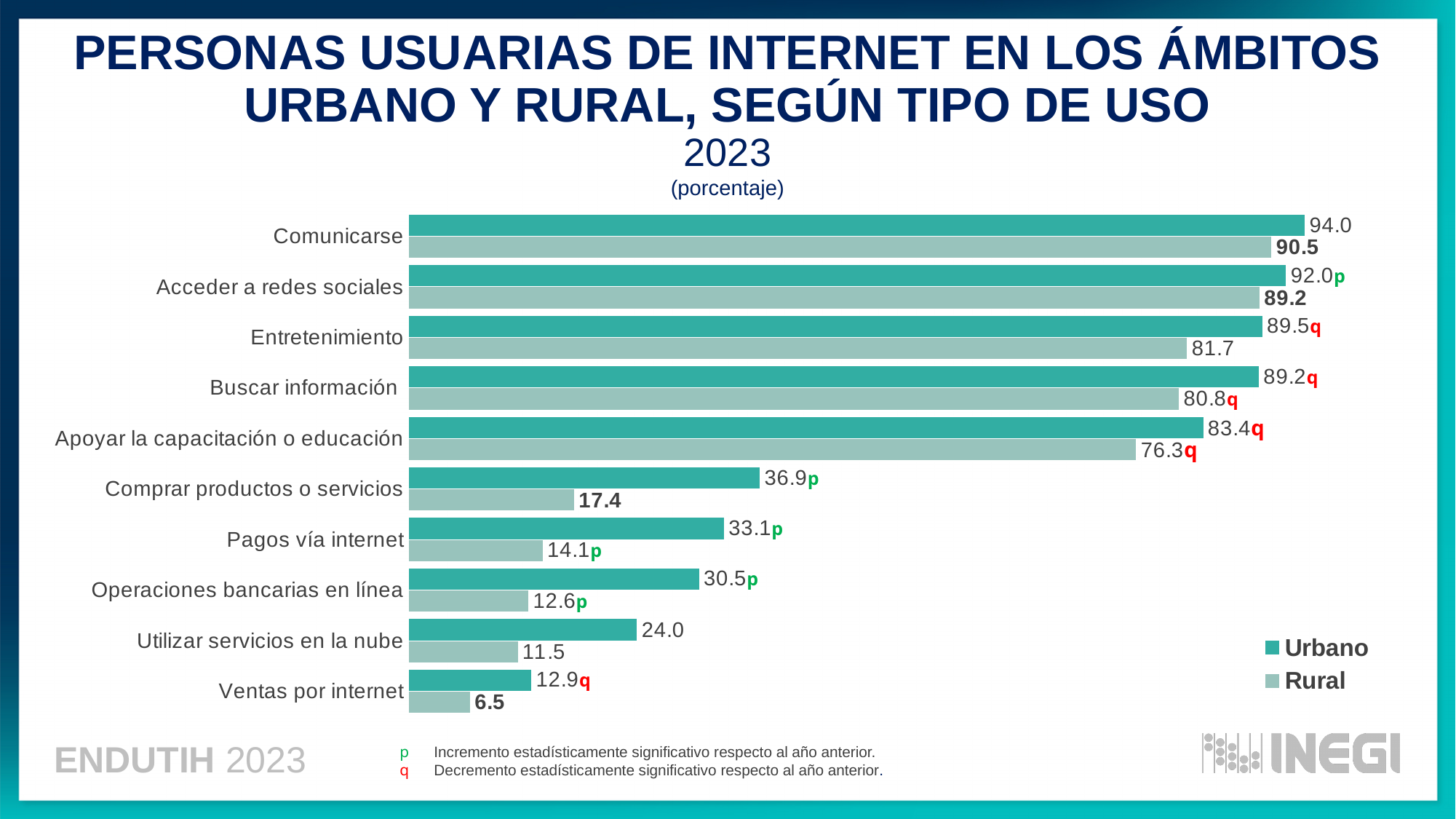
How many categories (types of use) are shown in the chart? 10 What is the Rural value for Apoyar la capacitación o educación? 76.3 Which category has the lowest Rural value? Ventas por internet What kind of chart is shown on the slide? Bar chart What is the difference between the Urbano and Rural values for Entretenimiento? 7.8 How many series does the legend list? 2 Which is larger, the Urbano value for Utilizar servicios en la nube or the Urbano value for Operaciones bancarias en línea? Operaciones bancarias en línea What is the Rural value for Comprar productos o servicios? 17.4 Which category has the highest Urbano value? Comunicarse What is the difference between the Urbano and Rural values for Pagos vía internet? 19.0 What is the Urbano value for Comunicarse? 94.0 What are the two series named in the legend? Urbano and Rural